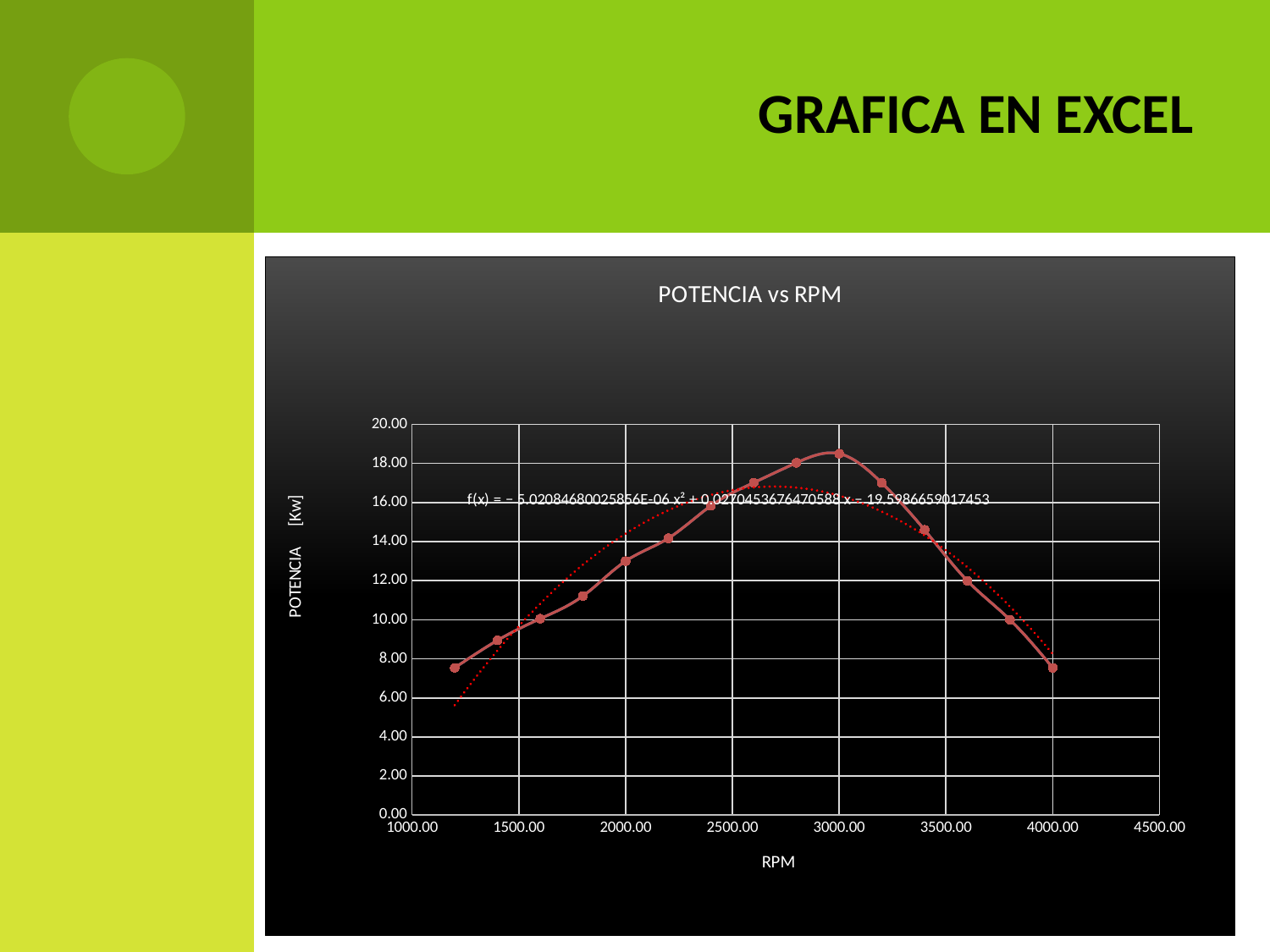
Is the value for 4000.00 RPM greater or less than 8.00? less At which RPM value does the plotted power (POTENCIA) reach its highest point? 3000.00 Which has the larger power value, 2800.00 RPM or 3600.00 RPM? 2800.00 RPM Is the value for 1200.00 RPM greater or less than 8.00? less What is the label of the x axis? RPM Between 1200.00 RPM and 3000.00 RPM, do the plotted values rise or fall? rise Is the value for 3000.00 RPM greater or less than 18.00? greater How many data points are plotted on the solid line? 15 What kind of chart is shown on the slide? line chart What is the title of the chart? POTENCIA vs RPM